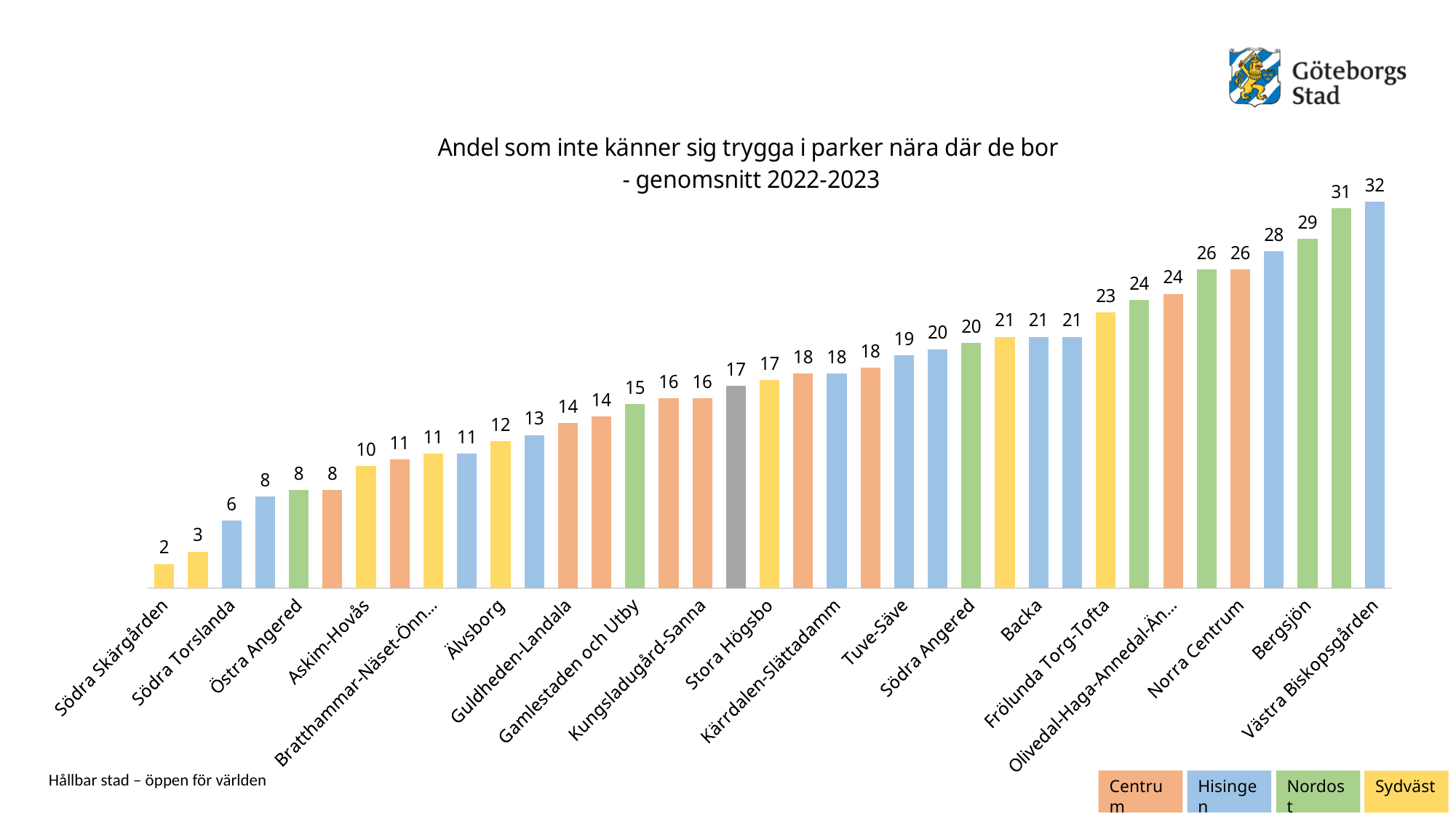
What is the value for Västra Biskopsgården? 32 What is the value for Södra Skärgården? 2 What kind of chart is shown? bar chart How many series does the legend list? 4 Which legend series does the colour of the Bergsjön bar correspond to? Nordost Which area has the highest value? Västra Biskopsgården What is the value for Backa? 21 What is the value for Bergsjön? 29 Which area has the lowest value? Södra Skärgården What is the difference between the values for Norra Centrum and Tuve-Säve? 7 Which is larger, the value for Frölunda Torg-Tofta or the value for Stora Högsbo? Frölunda Torg-Tofta Do the values rise or fall from left to right along the x axis? rise